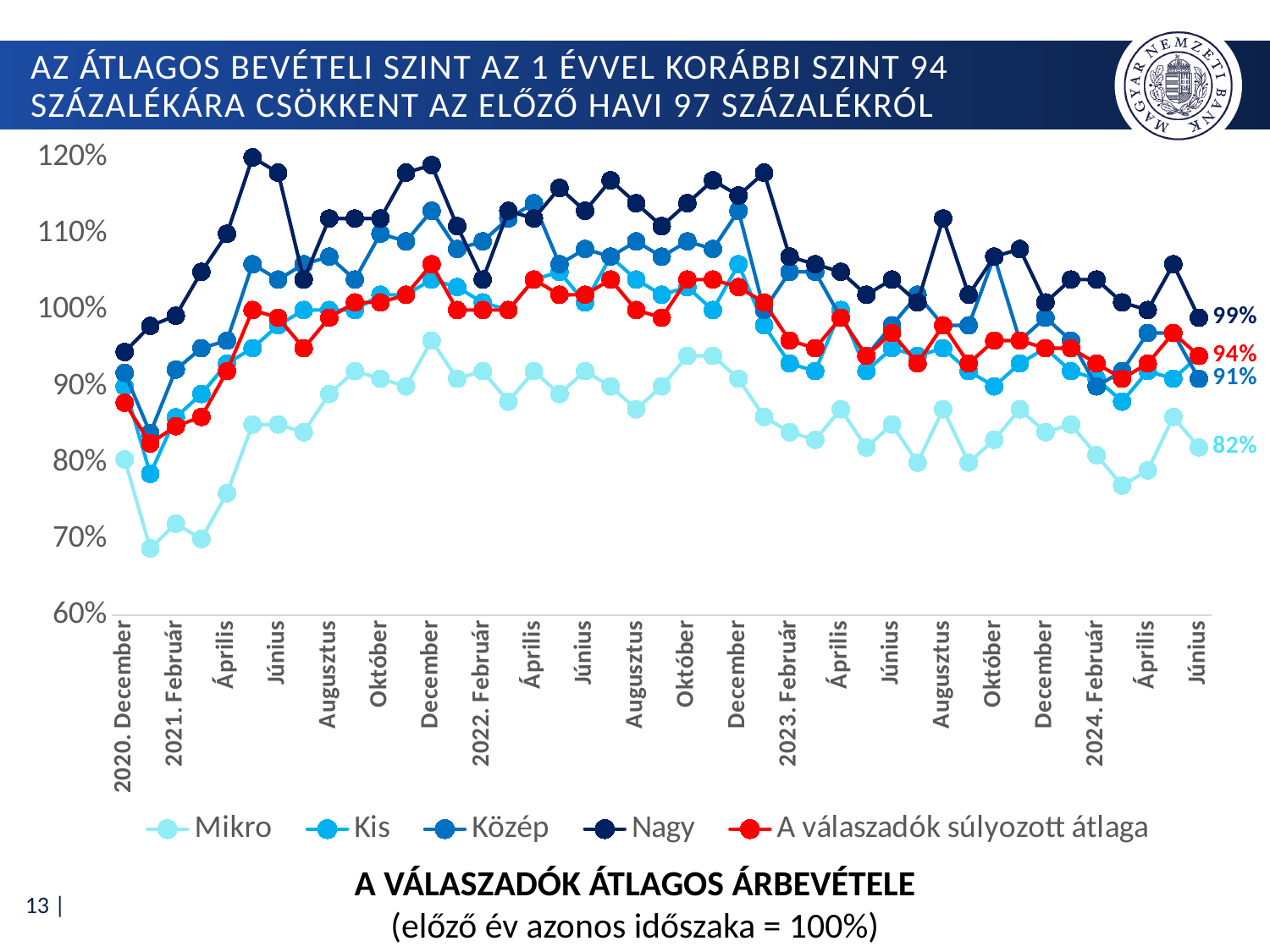
Is the value for Mikro in 2021. Február greater or less than 80%? less At the last point (2024 Június), which is larger: the Nagy value or the weighted average ('A válaszadók súlyozott átlaga')? Nagy What is the value for the Nagy series at the last point (2024 Június)? 99% Which series is drawn in red in the legend? A válaszadók súlyozott átlaga Is the value for Nagy in 2021 Június greater or less than 110%? greater What kind of chart is shown on the slide? line chart Which series has the lowest value at the last point (2024 Június)? Mikro What is the difference between the Nagy and Mikro values at the last point (2024 Június)? 17 percentage points Which series has the highest value at the last point (2024 Június)? Nagy What is the value for 'A válaszadók súlyozott átlaga' at the last point (2024 Június)? 94% How many series does the legend list? 5 What is the value for the Mikro series at the last point (2024 Június)? 82%